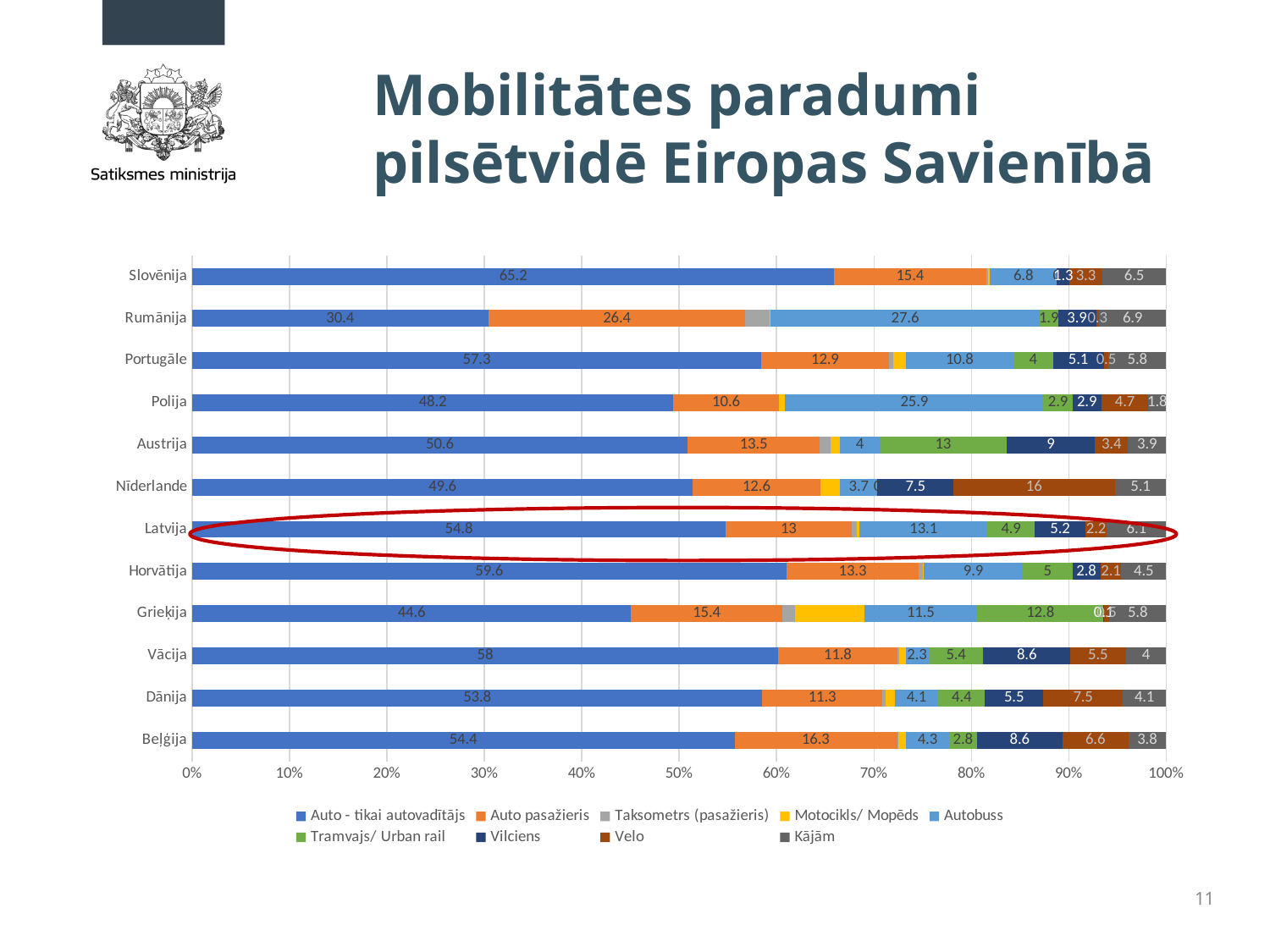
Which country has the highest value for 'Velo'? Nīderlande What type of chart is shown on the slide? Stacked bar chart Which is larger, the 'Tramvajs/ Urban rail' value for Austrija or for Latvija? Austrija What is the value of 'Autobuss' for Rumānija? 27.6 Which country has the highest value for 'Auto - tikai autovadītājs'? Slovēnija Which country has the lowest value for 'Auto - tikai autovadītājs'? Rumānija What is the value of 'Auto - tikai autovadītājs' for Latvija? 54.8 Which country's bar is circled in red on the chart? Latvija What is the difference between the 'Auto - tikai autovadītājs' values for Slovēnija and Rumānija? 34.8 What is the value of 'Velo' for Nīderlande? 16 How many countries are listed on the chart? 12 How many series does the legend list? 9